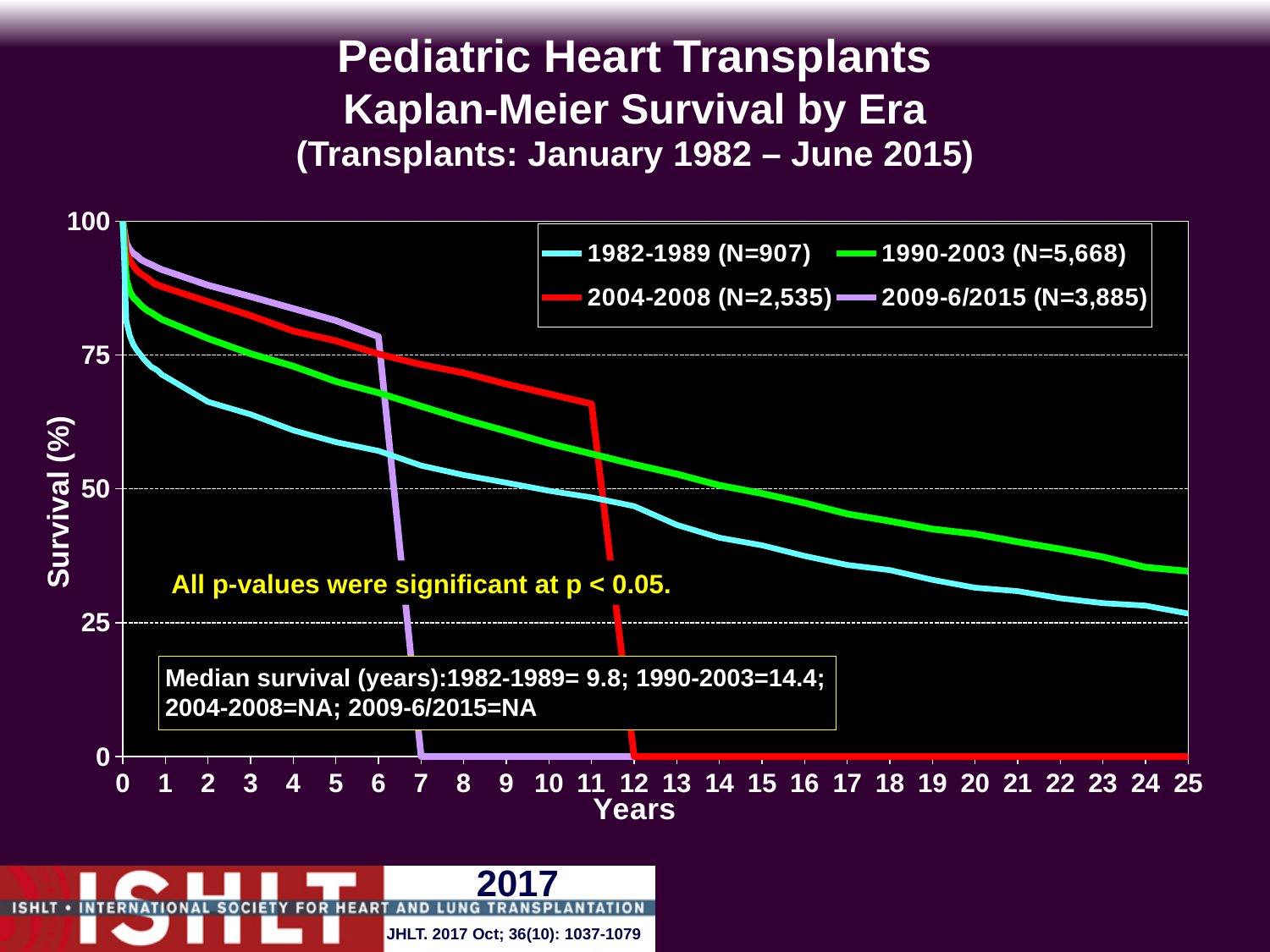
Is the survival for the 1982-1989 era at 25 years greater or less than 50? less What is the difference in median survival (years) between the 1990-2003 era and the 1982-1989 era? 4.6 What is the N shown in the legend for the 2004-2008 era? N=2,535 What kind of chart is shown on the slide? Line chart What is the label of the y axis? Survival (%) Is the survival for the 1990-2003 era at 5 years greater or less than 50? greater Do the survival curves rise or fall as years increase? fall How many series does the legend list? 4 What is the median survival listed for the 2009-6/2015 era? NA According to the text box, what is the median survival in years for the 1990-2003 era? 14.4 According to the text box, what is the median survival in years for the 1982-1989 era? 9.8 At 5 years, which era has higher survival: 2009-6/2015 or 1982-1989? 2009-6/2015